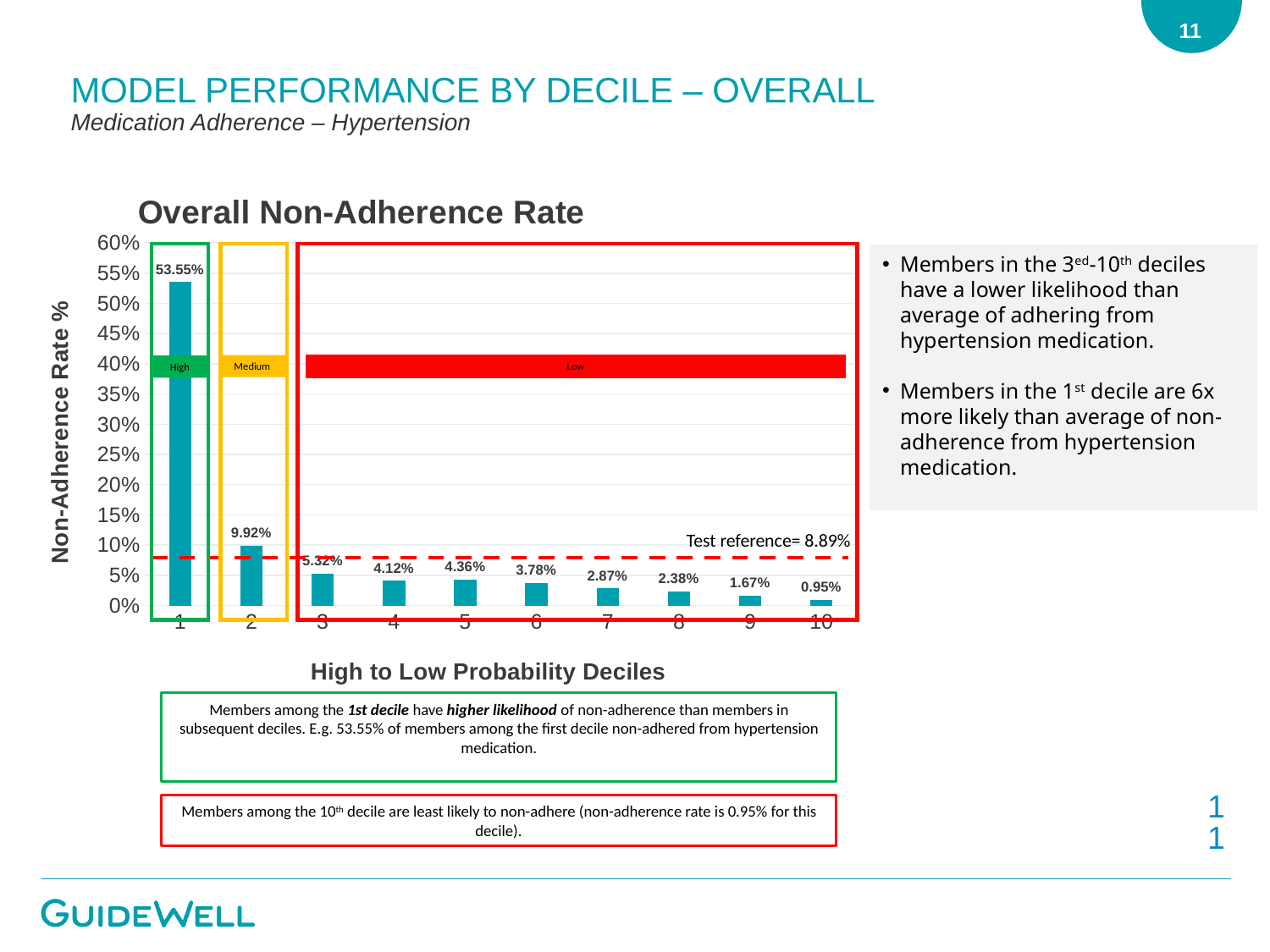
Which decile has the highest non-adherence rate? 1 What is the difference between the non-adherence rates of decile 1 and decile 2? 43.63% Which decile has the lowest non-adherence rate? 10 What is the non-adherence rate for decile 2? 9.92% Is the non-adherence rate for decile 1 greater or less than 50%? greater What is the test reference value marked by the dashed line? 8.89% What is the non-adherence rate for decile 7? 2.87% What is the non-adherence rate for decile 10? 0.95% Which has a higher non-adherence rate, decile 4 or decile 5? Decile 5 What kind of chart is used to show the Overall Non-Adherence Rate? Bar chart What is the non-adherence rate for decile 1? 53.55% How many deciles are shown on the x axis? 10